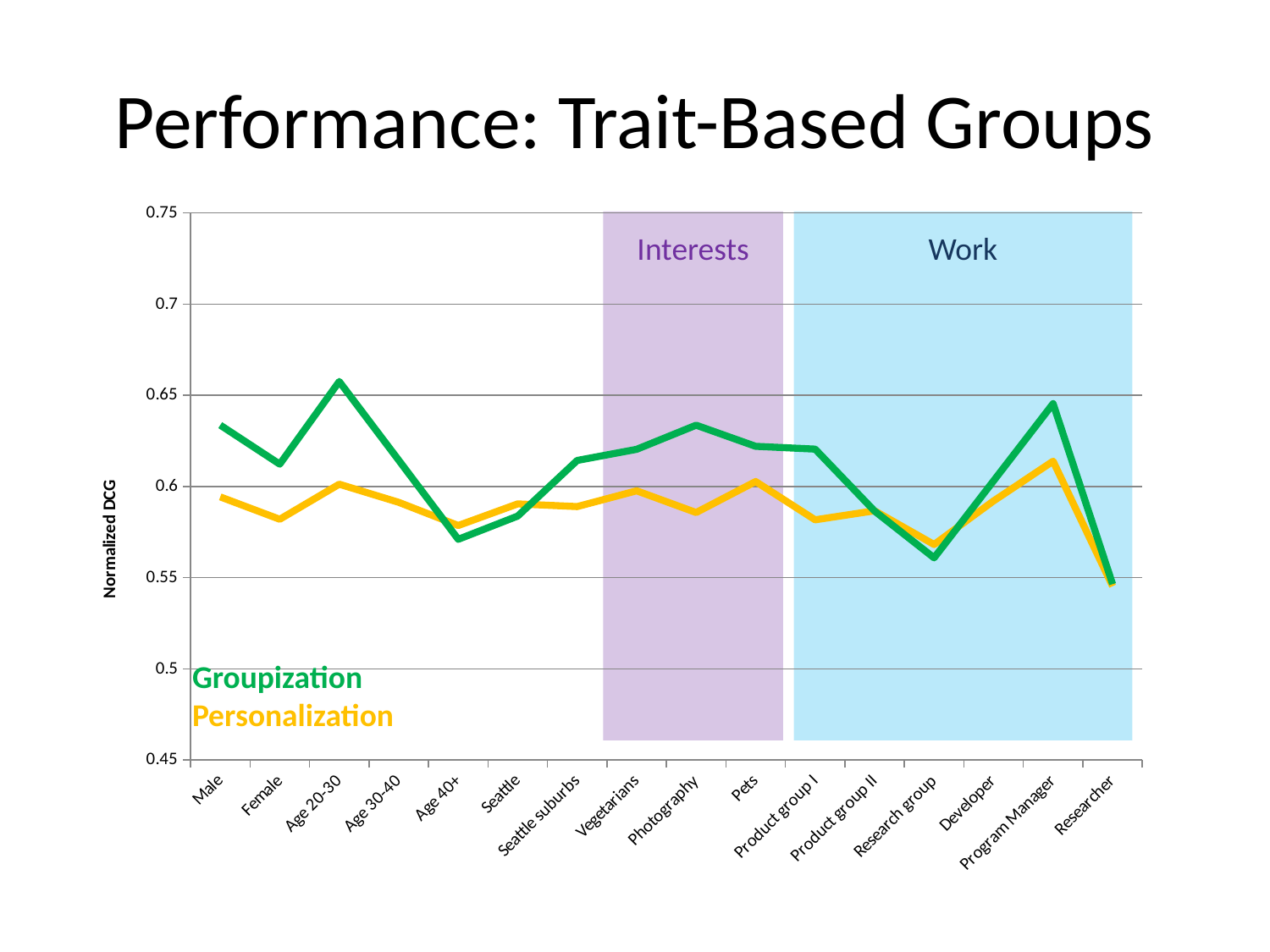
How many categories are plotted along the x axis? 16 Is the Groupization value for Male greater or less than 0.6? greater For Male, which series has the larger value, Groupization or Personalization? Groupization Is the Groupization value for Research group greater or less than 0.6? less For which category is the Groupization value lowest? Researcher For which category is the Groupization value highest? Age 20-30 How many series does the chart show? 2 For which category is the Personalization value lowest? Researcher What kind of chart is shown on the slide? line chart Which categories fall within the shaded region labelled Interests? Vegetarians, Photography, Pets Is the Personalization value for Program Manager greater or less than 0.6? greater What is the label of the y axis? Normalized DCG